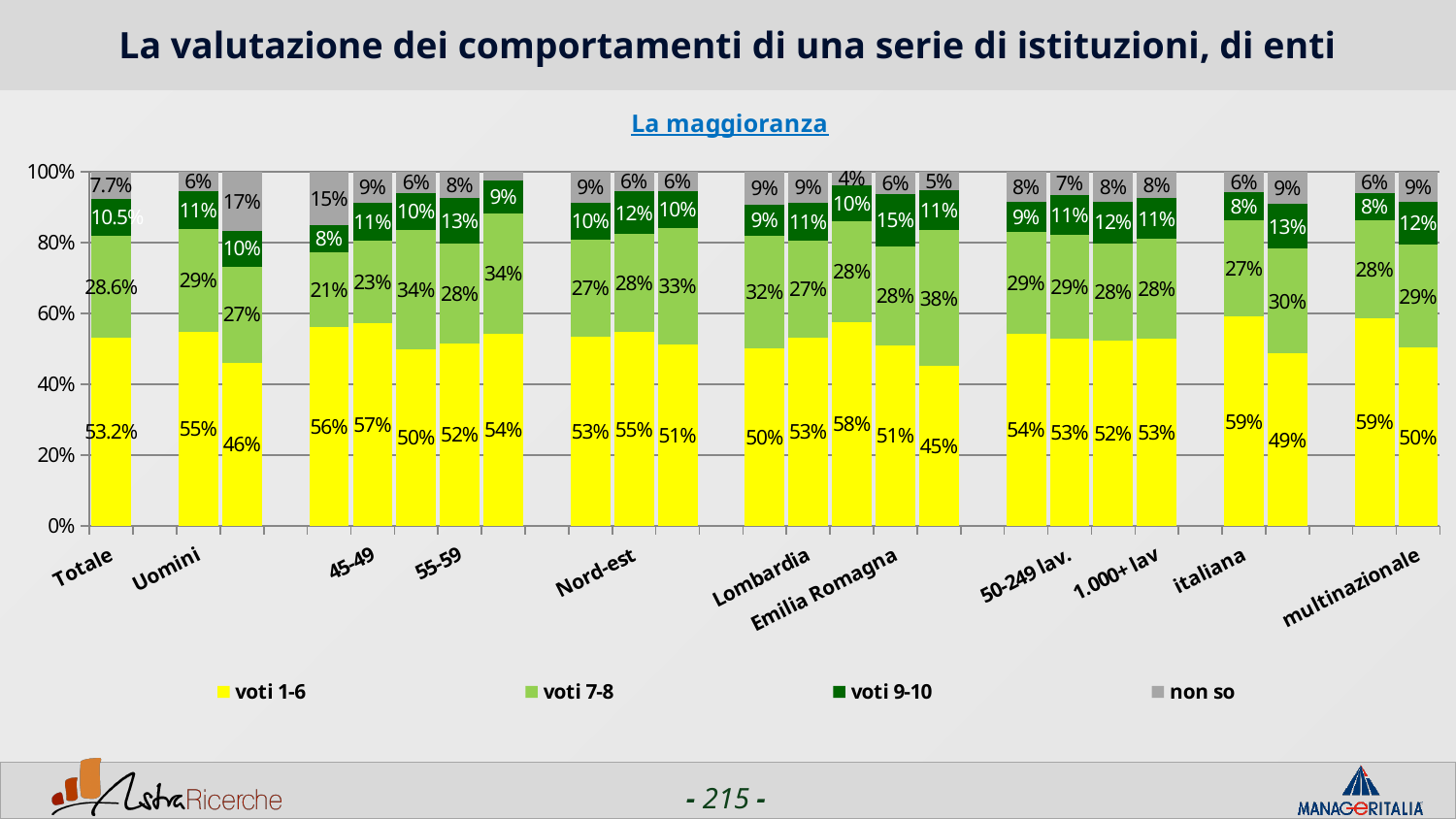
What is the value of 'voti 1-6' for Totale? 53.2% What is the first entry in the legend? voti 1-6 What is the value of 'voti 1-6' for italiana? 59% Which has the larger 'voti 1-6' value, Totale or Uomini? Uomini Is the 'voti 1-6' value for Totale greater or less than 40%? greater What kind of chart is shown on the slide? stacked bar chart What is the value of 'voti 9-10' for multinazionale? 12% What is the difference between the 'voti 1-6' values for italiana and multinazionale? 9 percentage points What is the value of 'non so' for Totale? 7.7% How many series does the legend list? 4 What is the value of 'voti 7-8' for Uomini? 29% What is the value of 'voti 9-10' for Emilia Romagna? 15%